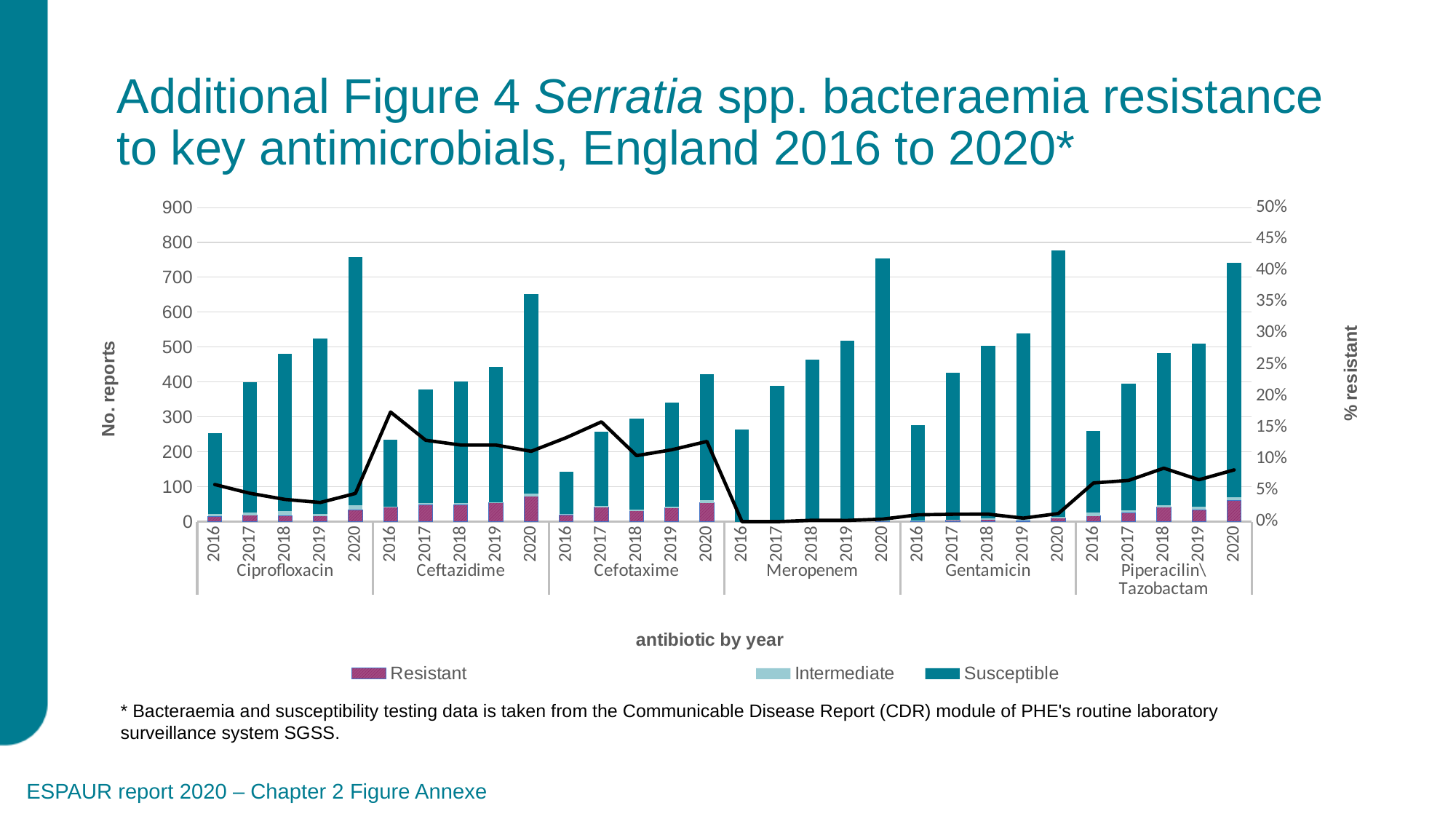
Which antibiotic and year has the shortest bar (fewest reports)? Cefotaxime 2016 How many antibiotics are shown along the x axis? 6 Is the total number of reports for Ciprofloxacin in 2020 greater or less than 700? greater How many bars are plotted in total on the chart? 30 What kind of chart is shown on the slide? Stacked bar chart with a line What is the label of the right-hand vertical axis? % resistant Which has more reports in 2020: Ciprofloxacin or Ceftazidime? Ciprofloxacin Is the % resistant line for Ceftazidime in 2016 greater or less than 15%? greater How many series does the legend list? 3 Is the total number of reports for Ceftazidime in 2020 greater or less than 600? greater Within each antibiotic, do the total reports rise or fall from 2016 to 2020? rise